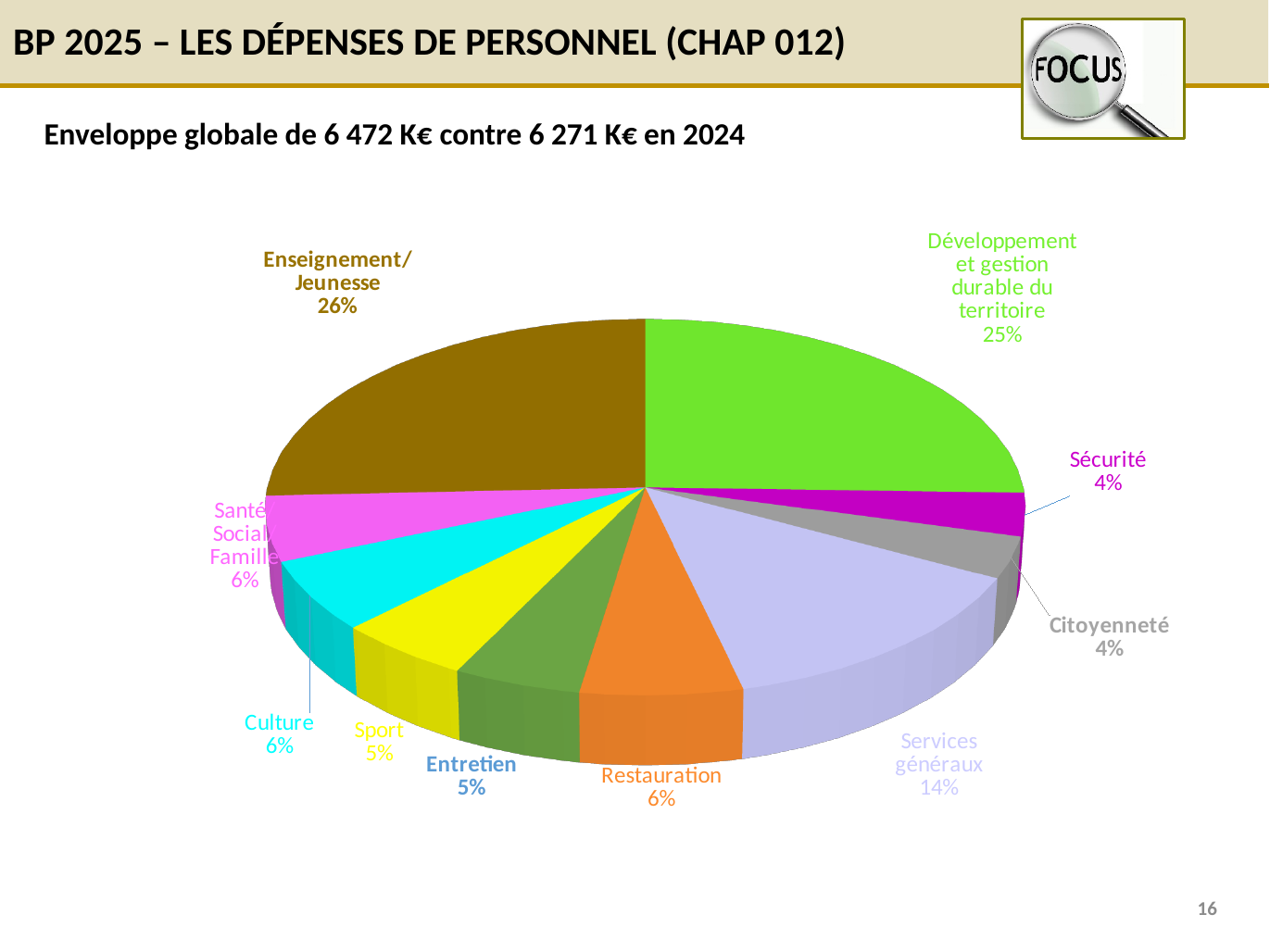
How many categories are shown in the pie chart? 10 What kind of chart is shown on the slide? pie chart What colour is the Restauration slice? orange What is the value shown for Sécurité? 4% What is the value shown for Entretien? 5% What is the value shown for Développement et gestion durable du territoire? 25% Which is larger, the share for Services généraux or the share for Restauration? Services généraux Which category has the largest share of the pie? Enseignement/Jeunesse What share of the pie does Services généraux represent? 14% What is the value shown for Restauration? 6% What share of the pie does Enseignement/Jeunesse represent? 26% What is the difference in percentage points between Enseignement/Jeunesse and Services généraux? 12